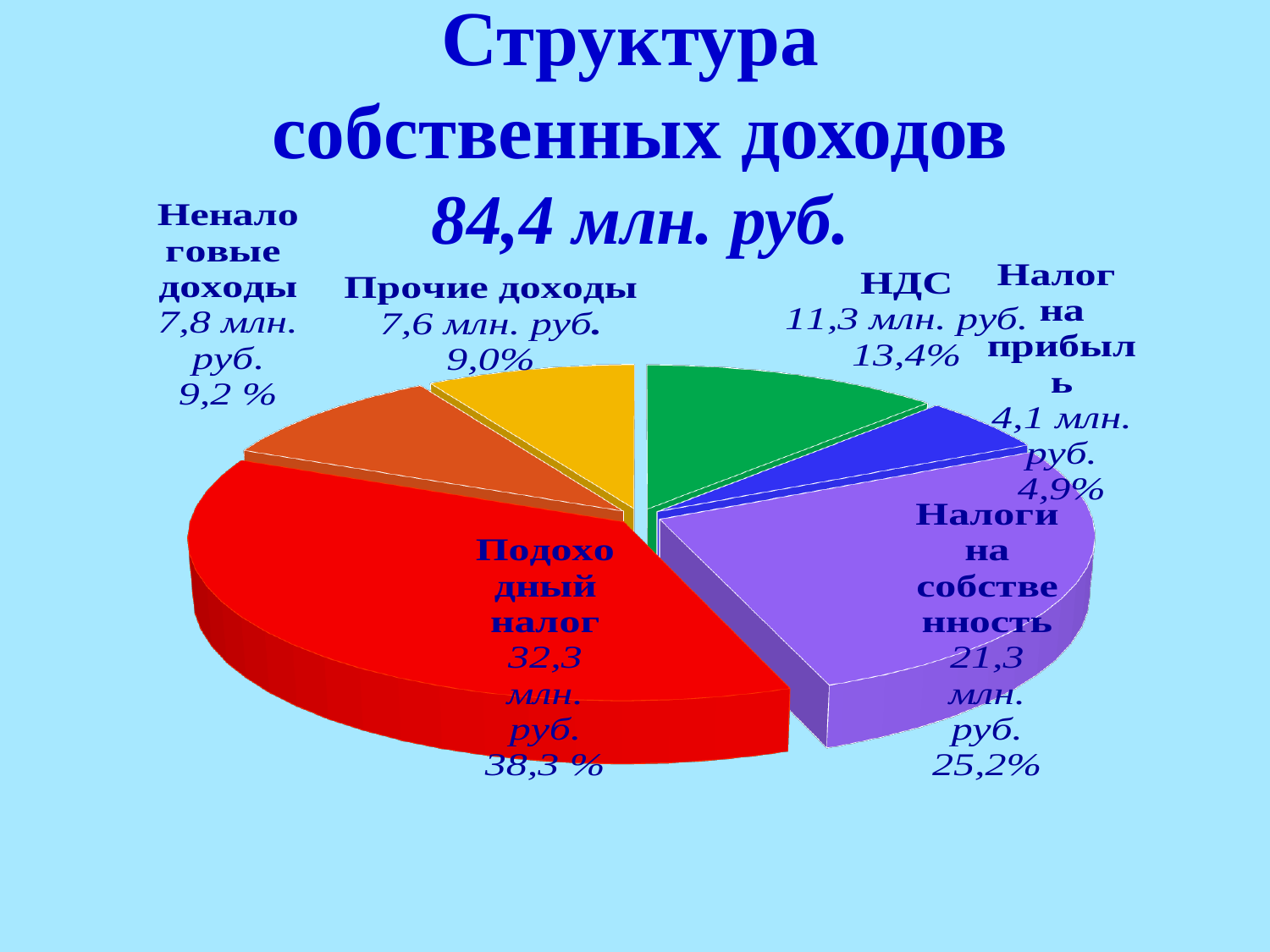
What is the value in млн. руб. for Налоги на собственность? 21,3 млн. руб. What total amount is stated in the chart title? 84,4 млн. руб. Which category has the smallest slice of the pie? Налог на прибыль Which category has the largest slice of the pie? Подоходный налог What percentage share does Неналоговые доходы have? 9,2 % What is the value in млн. руб. for Подоходный налог? 32,3 млн. руб. What percentage share does НДС have? 13,4% What is the difference in млн. руб. between Подоходный налог and Налоги на собственность? 11,0 млн. руб. What colour is the slice for Налог на прибыль? blue How many slices does the pie chart have? 6 Which is larger: НДС or Прочие доходы? НДС What kind of chart is shown on the slide? pie chart